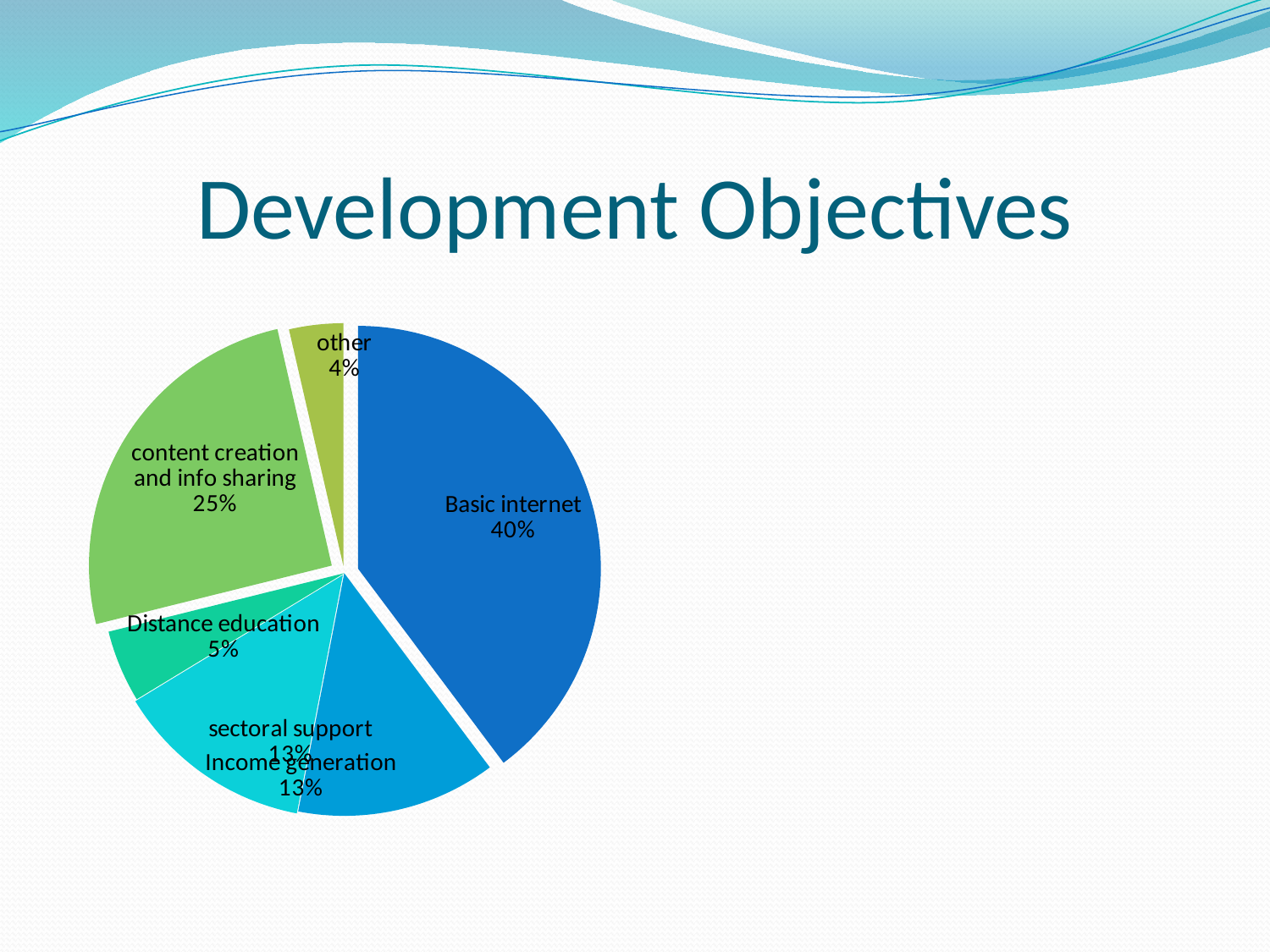
What share of the pie does the 'other' slice have? 4% Which slice is the largest in the pie chart? Basic internet What share of the pie does content creation and info sharing have? 25% What share of the pie does Distance education have? 5% What is the difference in percentage points between Basic internet and content creation and info sharing? 15 What is the title of the slide containing the pie chart? Development Objectives Which slice is the smallest in the pie chart? other How many slices does the pie chart have? 6 Which is larger, the Distance education slice or the sectoral support slice? sectoral support What kind of chart is shown on the slide? pie chart